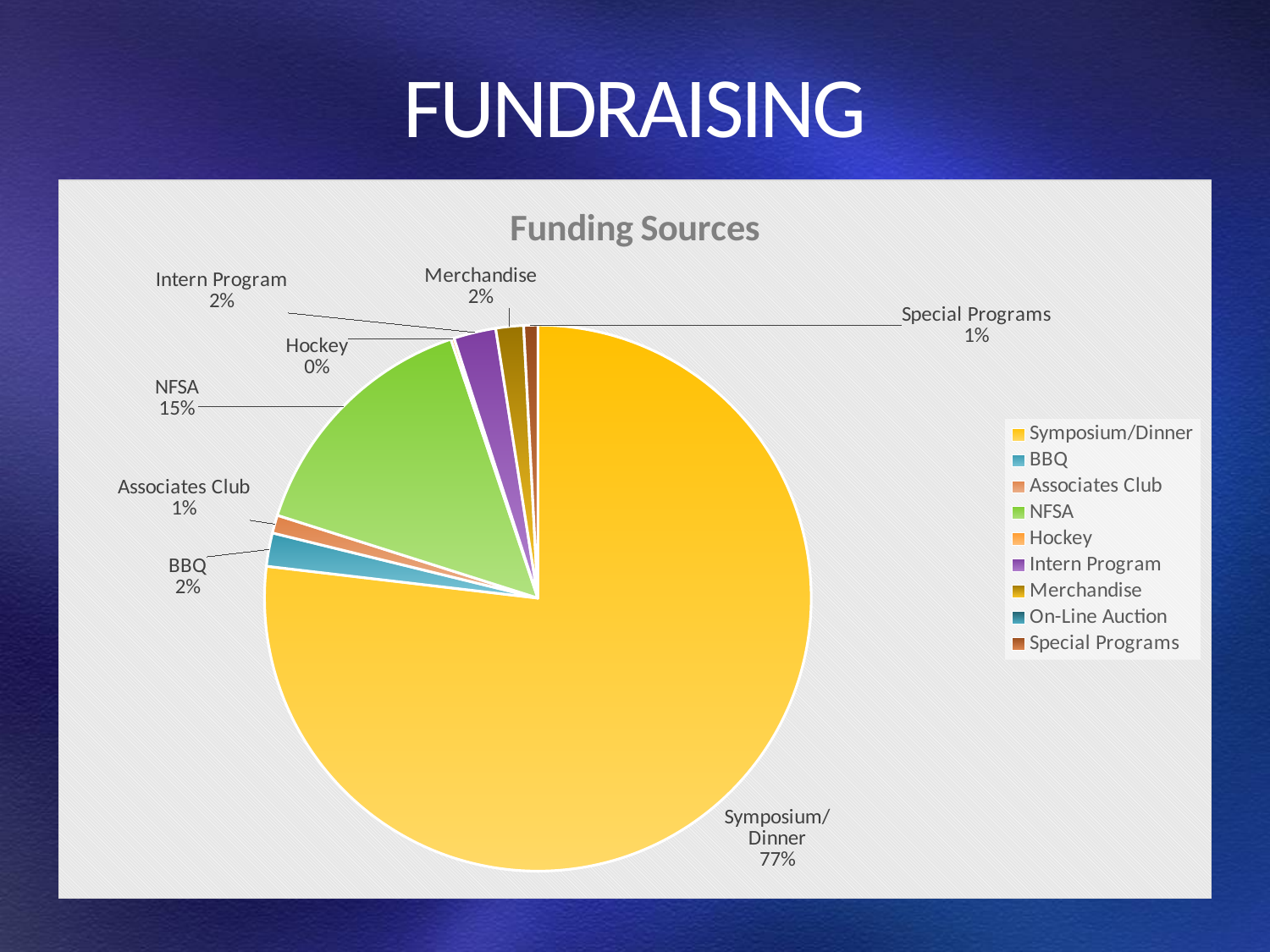
Which labelled funding source has the smallest share? Hockey Which is larger, the NFSA share or the Merchandise share? NFSA Which funding source has the largest share of the pie? Symposium/Dinner What percentage of funding comes from NFSA? 15% What percentage is shown for Hockey? 0% What percentage is shown for Special Programs? 1% How many percentage points larger is the Symposium/Dinner share than the NFSA share? 62 How many entries does the legend list? 9 What type of chart is shown on the slide? Pie chart What share of funding sources does Symposium/Dinner account for? 77% What percentage is shown for the BBQ slice? 2% What percentage is shown for the Intern Program slice? 2%